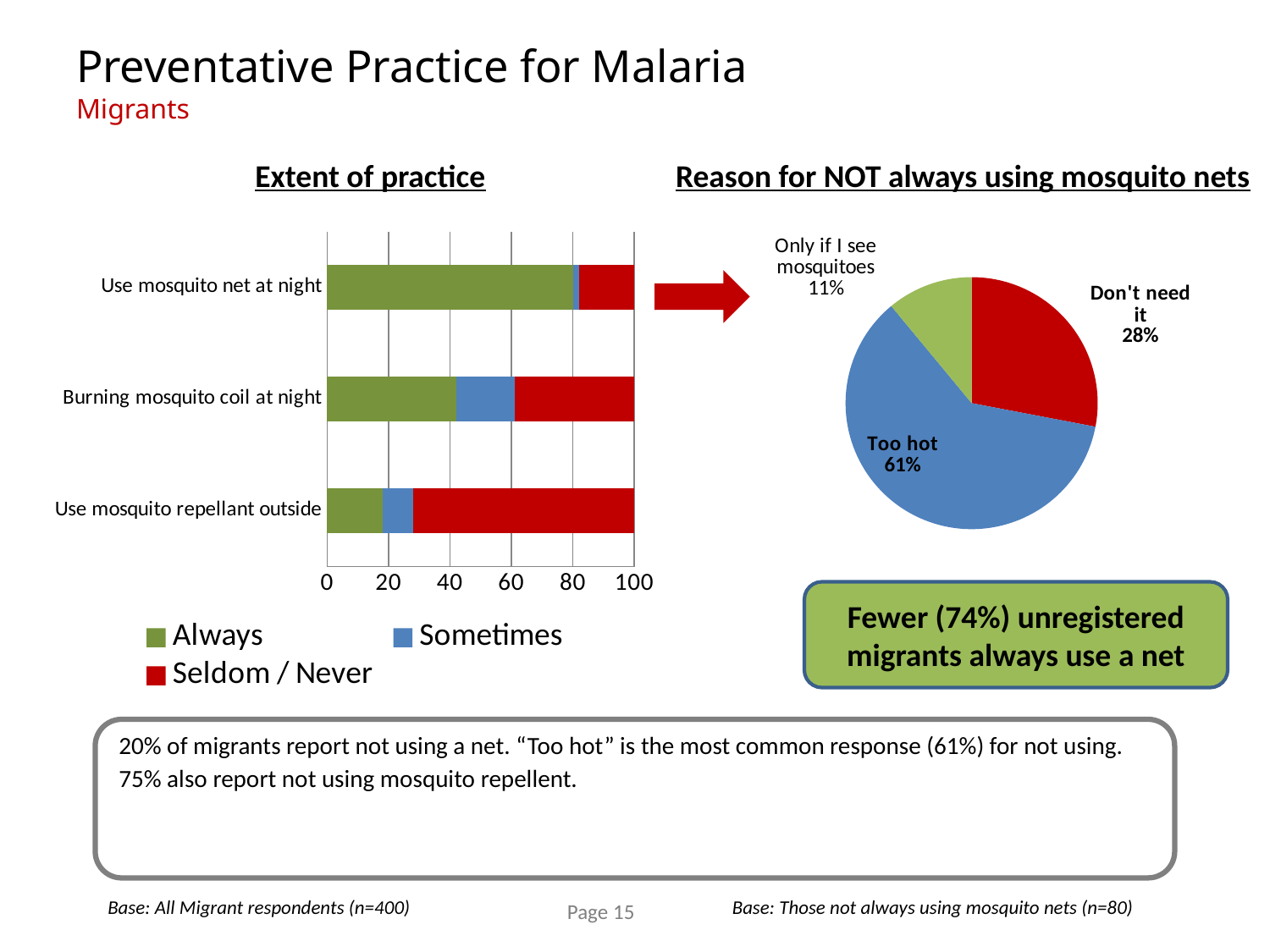
What kind of chart is the 'Extent of practice' chart? Stacked bar chart In the 'Extent of practice' chart, is the 'Always' value for 'Use mosquito repellant outside' greater or less than 40? less How many series does the legend of the 'Extent of practice' chart list? 3 In the 'Extent of practice' chart, which category has the largest 'Always' segment? Use mosquito net at night In the 'Extent of practice' chart, is the 'Always' value for 'Use mosquito net at night' greater or less than 60? greater In the 'Reason for NOT always using mosquito nets' pie chart, how many percentage points larger is 'Too hot' than 'Don't need it'? 33 How many slices does the 'Reason for NOT always using mosquito nets' pie chart have? 3 In the 'Reason for NOT always using mosquito nets' pie chart, which reason has the smallest share? Only if I see mosquitoes In the 'Reason for NOT always using mosquito nets' pie chart, what share is 'Only if I see mosquitoes'? 11% In the 'Reason for NOT always using mosquito nets' pie chart, what share is 'Don't need it'? 28% In the 'Reason for NOT always using mosquito nets' pie chart, what share is 'Too hot'? 61% In the 'Reason for NOT always using mosquito nets' pie chart, which reason has the largest share? Too hot